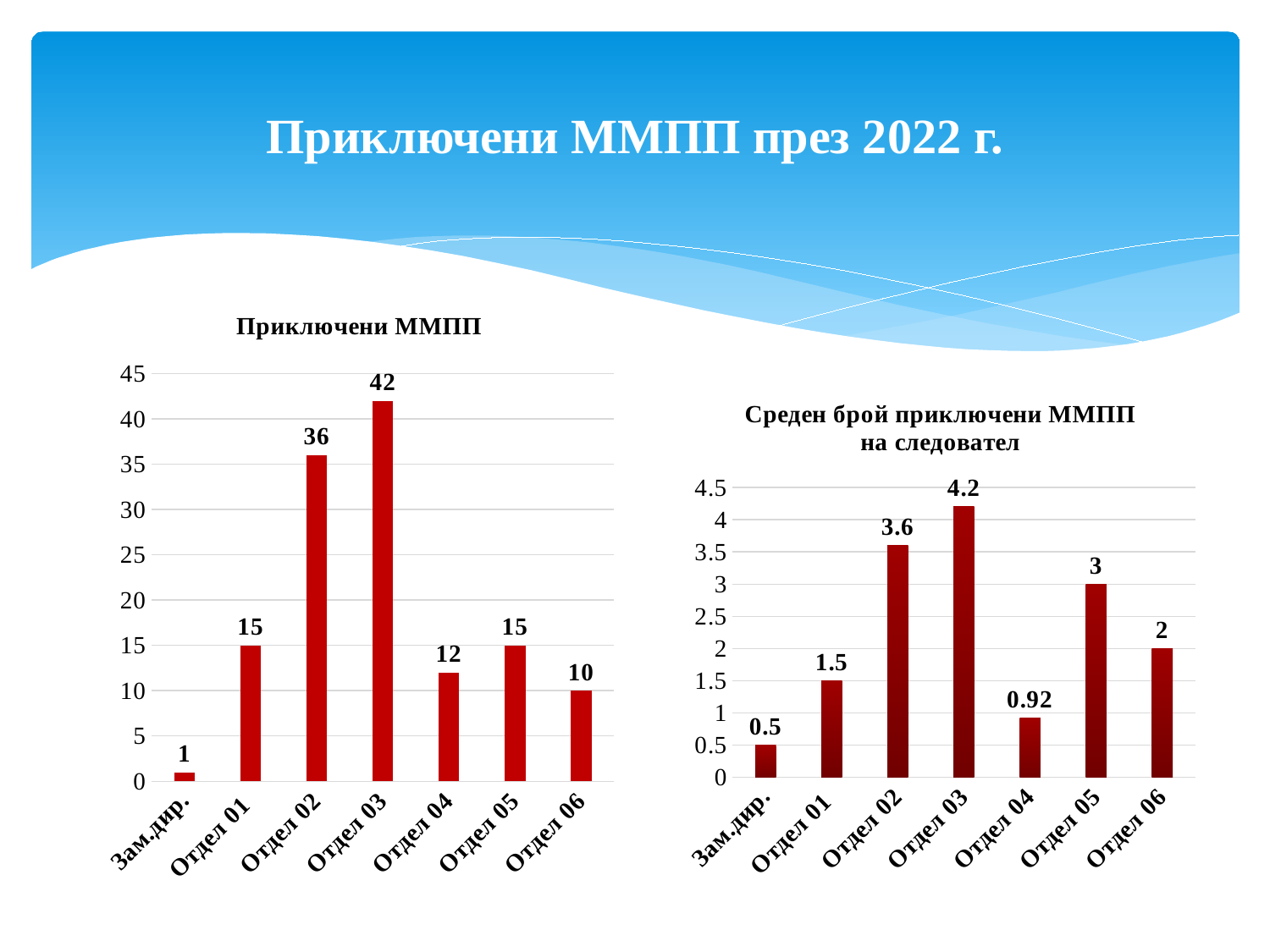
In the right chart 'Среден брой приключени ММПП на следовател', which is larger, Отдел 05 or Отдел 06? Отдел 05 In the right chart 'Среден брой приключени ММПП на следовател', what is the value for Отдел 04? 0.92 In the left chart 'Приключени ММПП', what is the difference between Отдел 02 and Отдел 06? 26 In the right chart 'Среден брой приключени ММПП на следовател', which category has the highest value? Отдел 03 In the right chart 'Среден брой приключени ММПП на следовател', what is the difference between Отдел 03 and Отдел 02? 0.6 In the left chart 'Приключени ММПП', how many categories are shown on the x axis? 7 In the left chart 'Приключени ММПП', which category has the lowest value? Зам.дир. In the left chart 'Приключени ММПП', what is the value for Отдел 01? 15 In the left chart 'Приключени ММПП', what is the value for Отдел 03? 42 What is the title of the slide? Приключени ММПП през 2022 г. In the left chart 'Приключени ММПП', is the value for Отдел 04 greater or less than 10? greater What kind of chart is the right chart 'Среден брой приключени ММПП на следовател'? bar chart